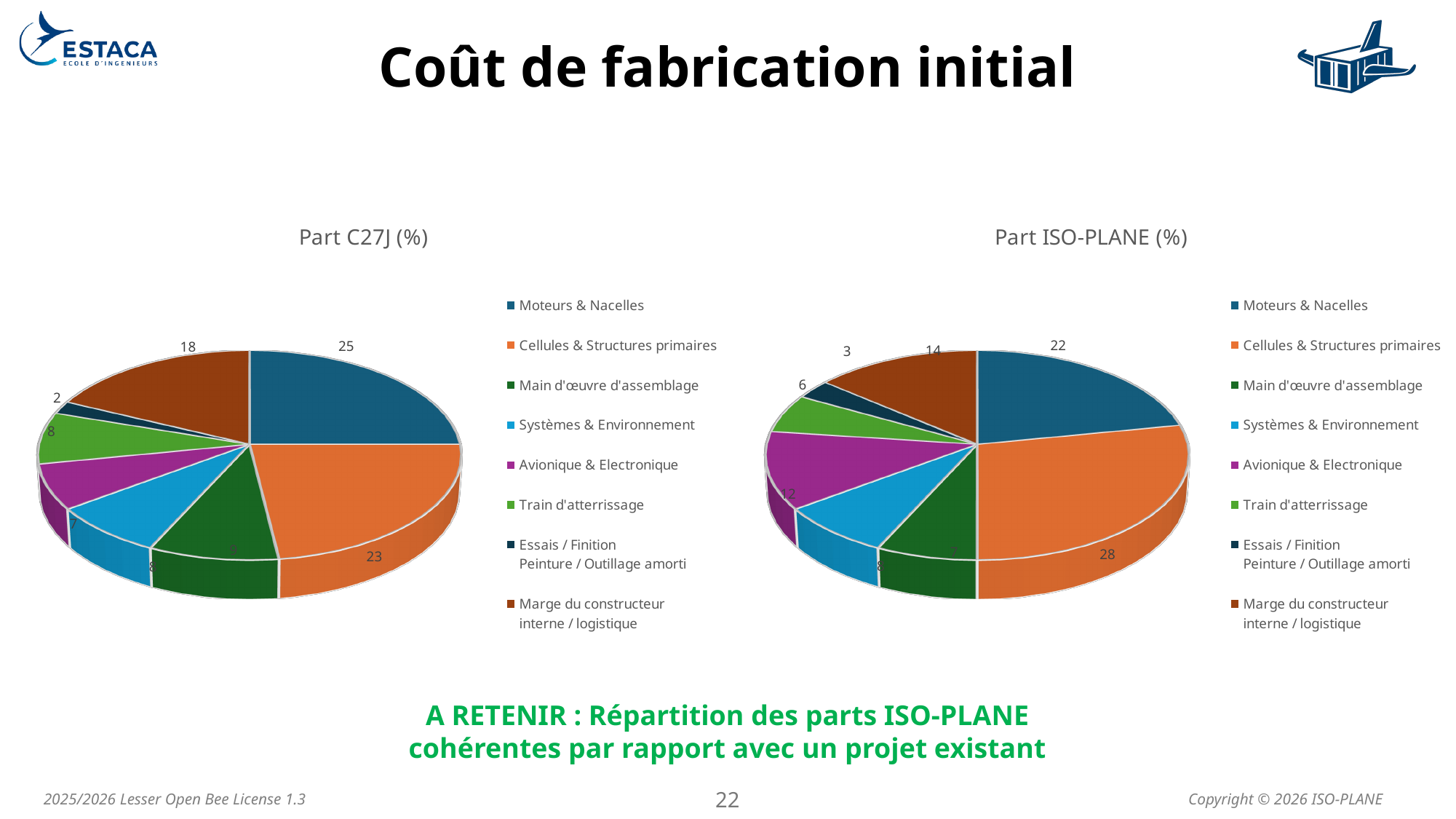
Which is larger: Marge du constructeur interne / logistique in the 'Part C27J (%)' chart or in the 'Part ISO-PLANE (%)' chart? Part C27J (%) In the 'Part ISO-PLANE (%)' chart, which category has the smallest share? Essais / Finition Peinture / Outillage amorti In the 'Part C27J (%)' chart, which category has the largest share? Moteurs & Nacelles In the 'Part ISO-PLANE (%)' chart, what is the value for Cellules & Structures primaires? 28 In the 'Part ISO-PLANE (%)' chart, what is the value for Train d'atterrissage? 6 What is the difference between the Moteurs & Nacelles value in the 'Part C27J (%)' chart and in the 'Part ISO-PLANE (%)' chart? 3 In the 'Part C27J (%)' chart, which category has the smallest share? Essais / Finition Peinture / Outillage amorti How many categories does the 'Part ISO-PLANE (%)' chart show? 8 In the 'Part C27J (%)' chart, what is the value for Marge du constructeur interne / logistique? 18 In the 'Part ISO-PLANE (%)' chart, which category has the largest share? Cellules & Structures primaires What kind of chart is the 'Part C27J (%)' chart? Pie chart In the 'Part C27J (%)' chart, what is the value for Moteurs & Nacelles? 25